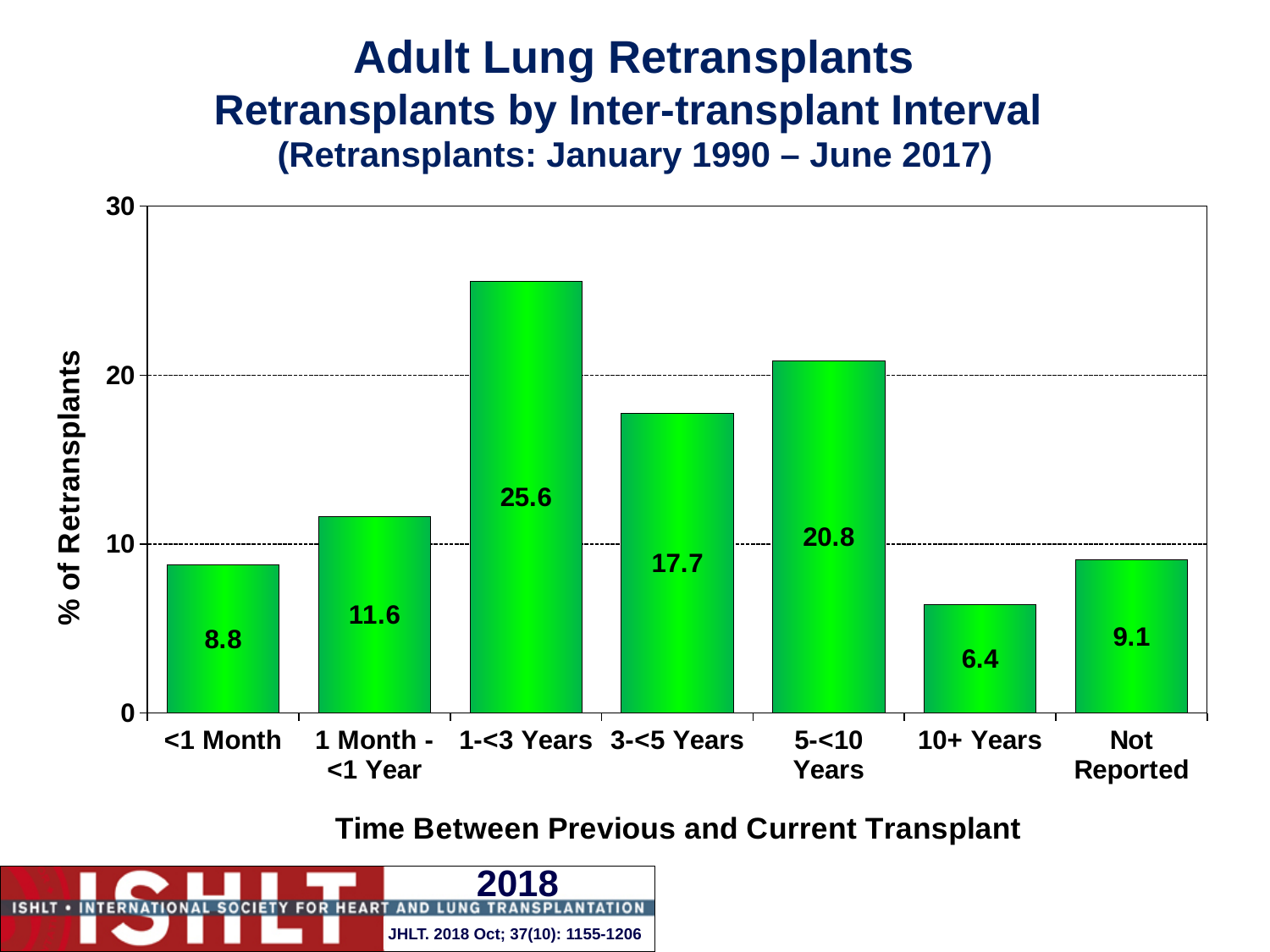
Which inter-transplant interval has the highest % of retransplants? 1-<3 Years How many categories are shown on the x axis? 7 Which category has the lowest % of retransplants? 10+ Years Is the value for 5-<10 Years greater or less than 20? greater Which has a higher % of retransplants: 3-<5 Years or 1 Month - <1 Year? 3-<5 Years What kind of chart is shown on the slide? Bar chart What is the % of retransplants for the <1 Month interval? 8.8 What is the label of the x axis? Time Between Previous and Current Transplant What is the difference in % of retransplants between the 1-<3 Years and 5-<10 Years intervals? 4.8 What is the label of the y axis? % of Retransplants What is the % of retransplants for the 1-<3 Years interval? 25.6 What is the % of retransplants for the Not Reported category? 9.1